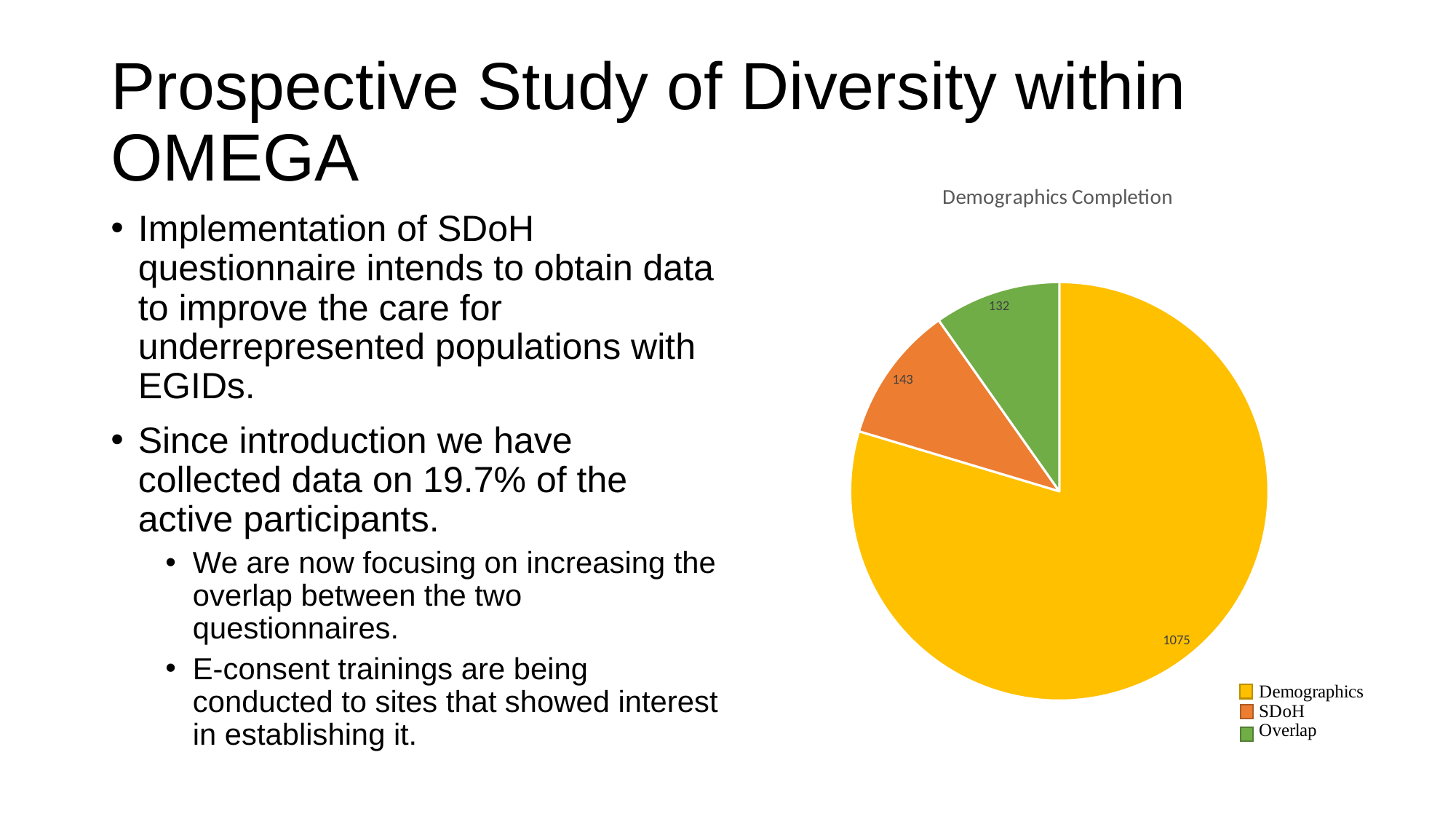
Which category has the smallest slice in the pie chart? Overlap What is the difference between the Demographics value and the SDoH value? 932 How many entries does the legend list? 3 What is the title of the chart? Demographics Completion What is the difference between the SDoH value and the Overlap value? 11 What is the value of the Overlap slice? 132 What type of chart is shown on the slide? Pie chart Which category has the largest slice in the pie chart? Demographics What is the value of the Demographics slice? 1075 What is the value of the SDoH slice? 143 Which is larger, the SDoH slice or the Overlap slice? SDoH How many slices does the pie chart have? 3